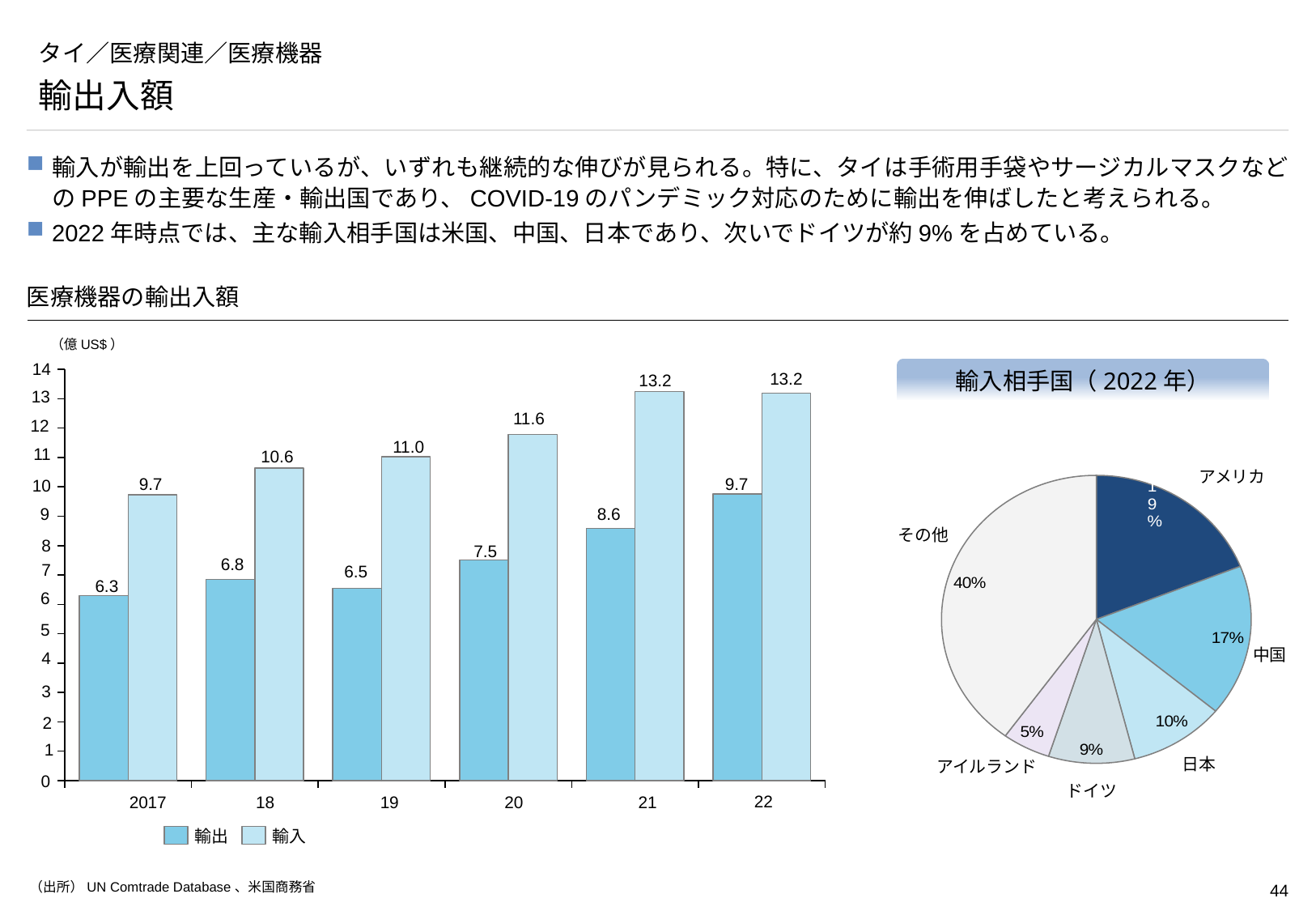
In the bar chart 医療機器の輸出入額, does the 輸入 series generally rise or fall from 2017 to 22? rise In the bar chart 医療機器の輸出入額, what is the 輸入 value for 2017? 9.7 In the bar chart 医療機器の輸出入額, what is the difference between 輸入 and 輸出 in 22? 3.5 In the bar chart 医療機器の輸出入額, how many years are shown on the x axis? 6 In the bar chart 医療機器の輸出入額, which year has the lowest 輸出 value? 2017 In the pie chart 輸入相手国（2022年）, how many slices are there? 6 In the pie chart 輸入相手国（2022年）, what share does 中国 have? 17% In the pie chart 輸入相手国（2022年）, which named country has the smallest share? アイルランド In the bar chart 医療機器の輸出入額, how many series does the legend list? 2 In the bar chart 医療機器の輸出入額, which is larger in 19, 輸出 or 輸入? 輸入 What type of chart is 医療機器の輸出入額? bar chart In the bar chart 医療機器の輸出入額, what is the 輸出 value for 21? 8.6